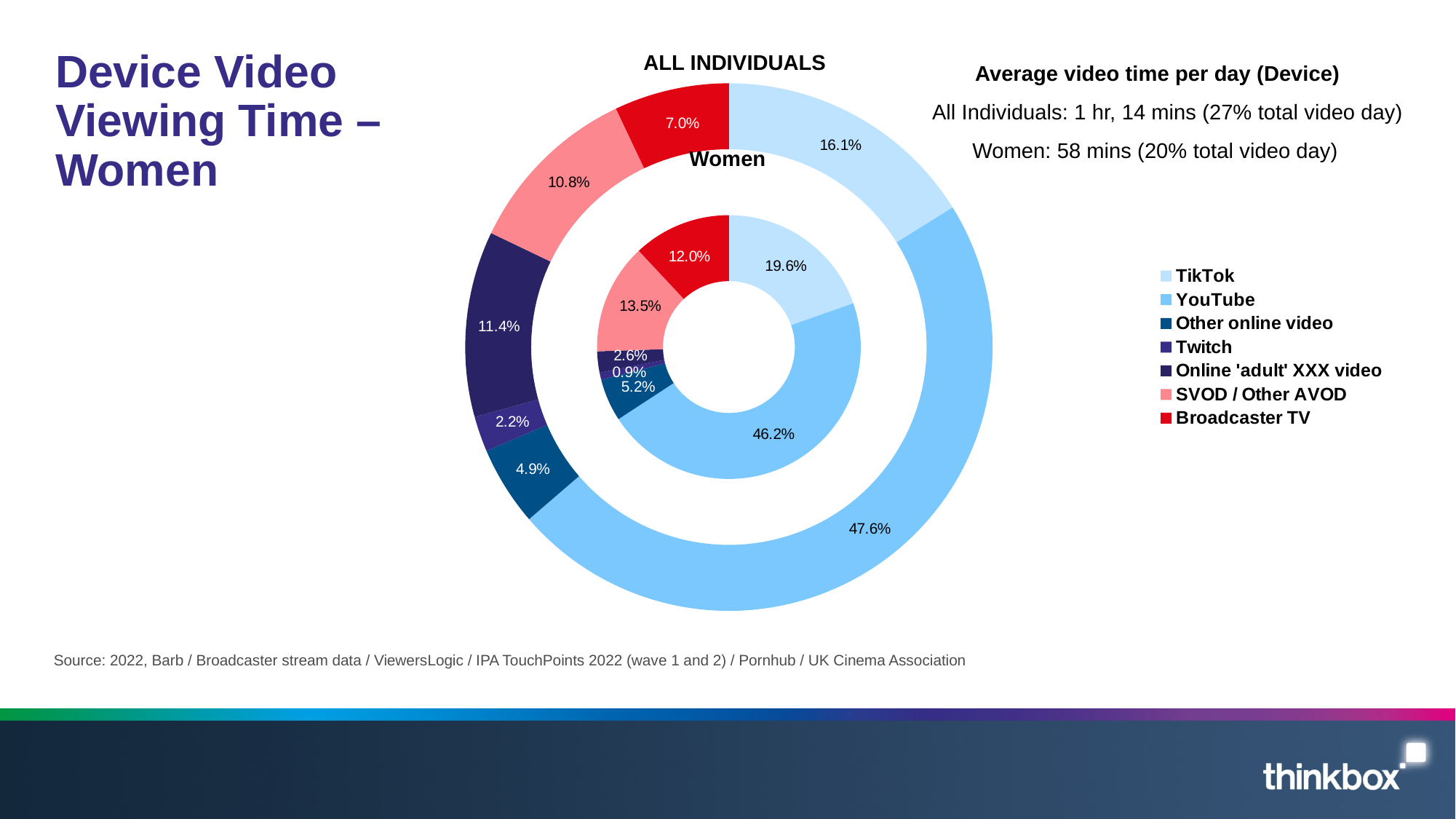
In the outer ring (All Individuals), what share does YouTube have? 47.6% What is the difference between the TikTok share for Women and for All Individuals? 3.5% Which category has the largest share in the Women ring? YouTube What type of chart is shown on the slide? Doughnut chart In the inner ring (Women), what share does TikTok have? 19.6% Is the Broadcaster TV share larger for Women or for All Individuals? Women Which category has the smallest share in the Women ring? Twitch What is the difference between the Broadcaster TV share for Women and for All Individuals? 5.0% According to the text on the slide, what is the average video time per day on devices for Women? 58 mins (20% total video day) In the outer ring (All Individuals), what share does SVOD / Other AVOD have? 10.8% How many categories does the legend list? 7 In the inner ring (Women), what share does Broadcaster TV have? 12.0%